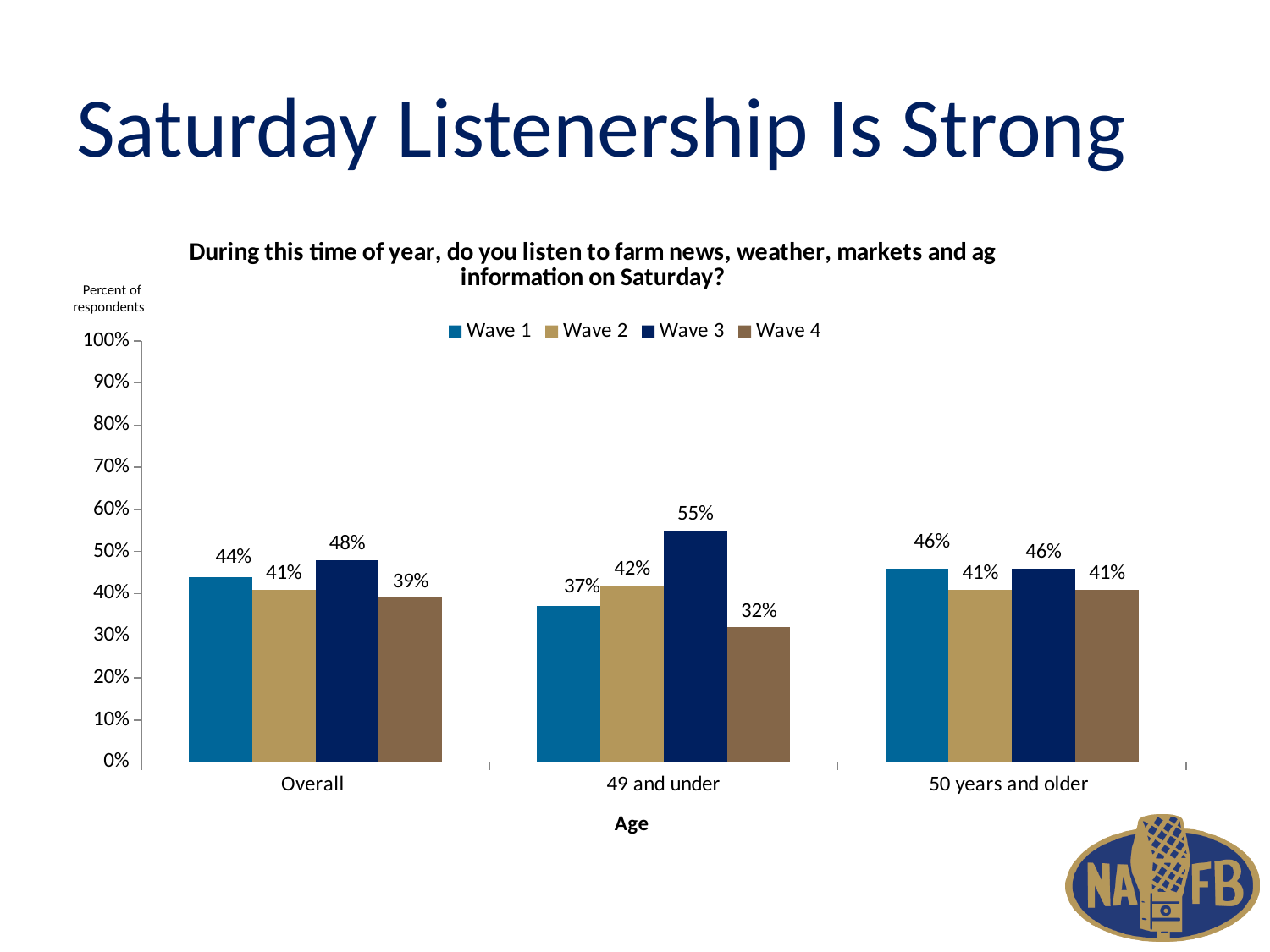
What is the Wave 1 value for 50 years and older? 46% Is the Wave 4 value for 49 and under greater or less than 40%? less What kind of chart is shown on the slide? Bar chart Which is larger for the Overall category: Wave 1 or Wave 2? Wave 1 How many age categories are shown on the x axis? 3 What is the Wave 4 value for the Overall category? 39% What is the Wave 3 value for the 49 and under group? 55% Which wave has the lowest value in the 49 and under group? Wave 4 What is the label of the x axis? Age Which wave has the highest value in the 49 and under group? Wave 3 How many series does the legend list? 4 What is the difference between the Wave 3 and Wave 4 values for 49 and under? 23 percentage points